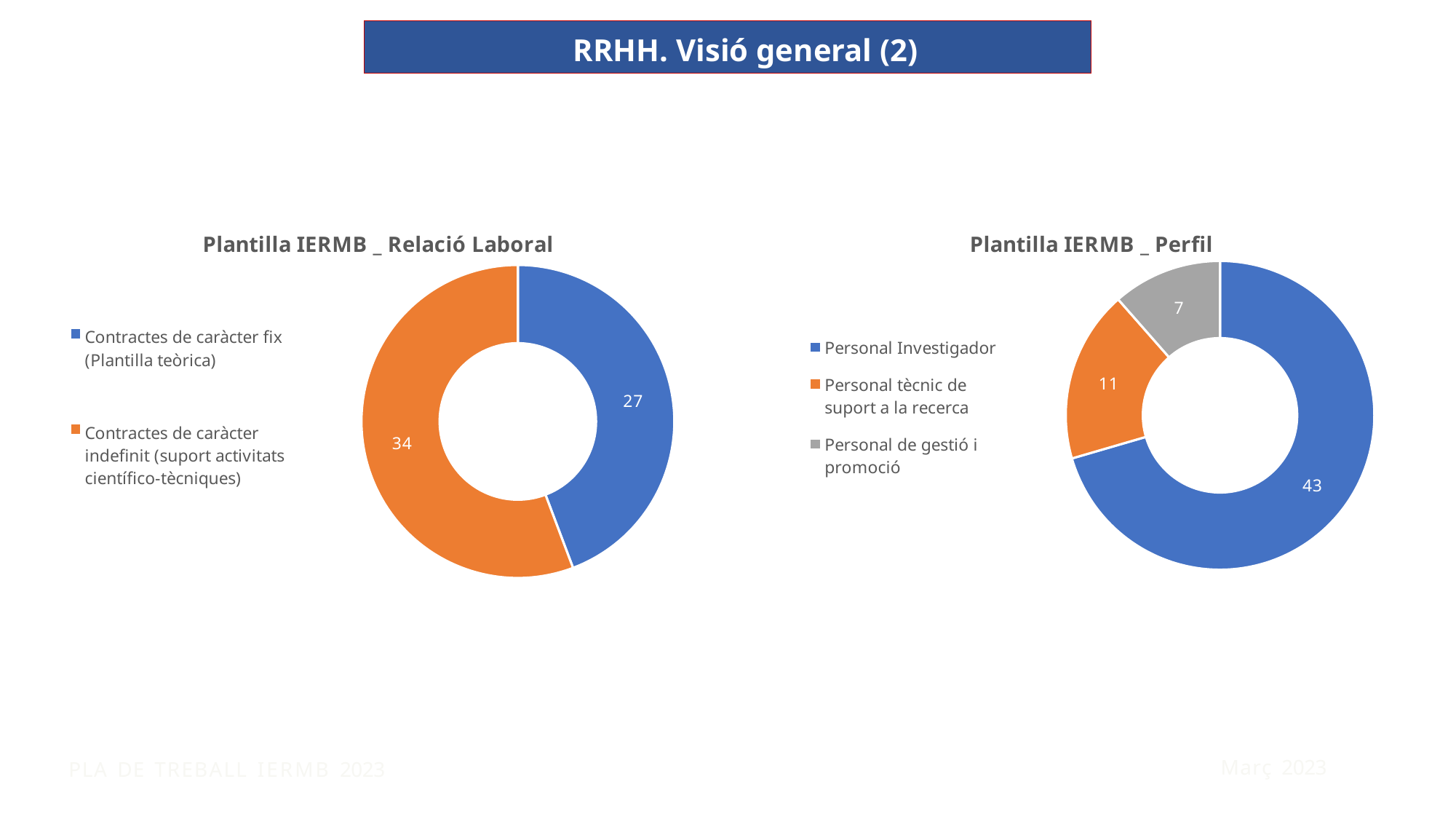
In the 'Plantilla IERMB _ Perfil' chart, what is the value for 'Personal de gestió i promoció'? 7 In the 'Plantilla IERMB _ Perfil' chart, what is the value for 'Personal Investigador'? 43 In the 'Plantilla IERMB _ Relació Laboral' chart, what is the difference between the two values? 7 In the 'Plantilla IERMB _ Perfil' chart, which category has the smallest value? Personal de gestió i promoció What kind of chart is the 'Plantilla IERMB _ Perfil' chart? Doughnut chart In the 'Plantilla IERMB _ Perfil' chart, how many categories are shown? 3 In the 'Plantilla IERMB _ Relació Laboral' chart, what is the total of the two slices? 61 In the 'Plantilla IERMB _ Relació Laboral' chart, which category has the larger value? Contractes de caràcter indefinit (suport activitats científico-tècniques) In the 'Plantilla IERMB _ Relació Laboral' chart, what is the value for 'Contractes de caràcter fix (Plantilla teòrica)'? 27 In the 'Plantilla IERMB _ Perfil' chart, what is the difference between 'Personal Investigador' and 'Personal tècnic de suport a la recerca'? 32 In the 'Plantilla IERMB _ Perfil' chart, what is the value for 'Personal tècnic de suport a la recerca'? 11 In the 'Plantilla IERMB _ Relació Laboral' chart, what is the value for 'Contractes de caràcter indefinit (suport activitats científico-tècniques)'? 34